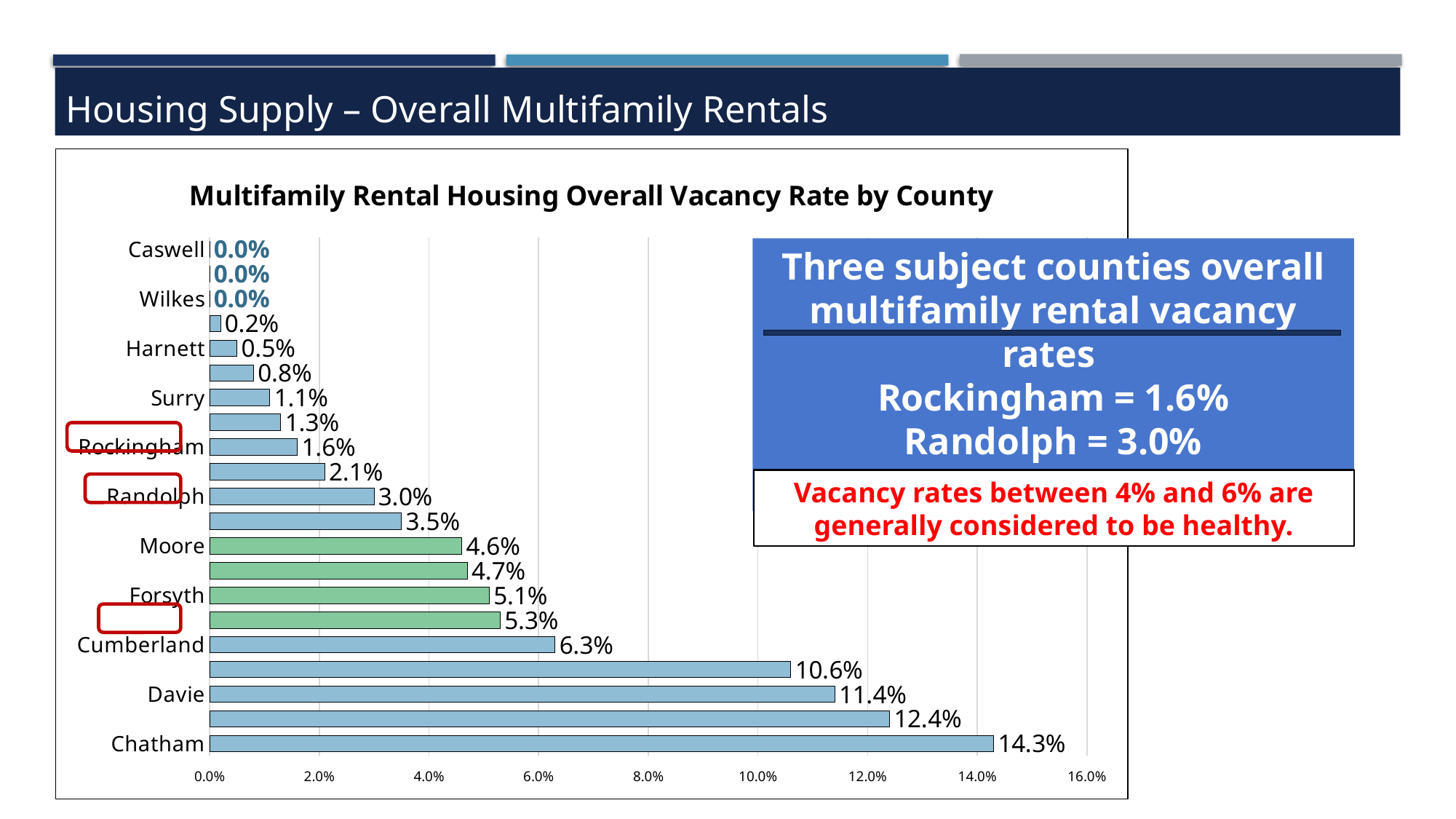
What is the vacancy rate for Cumberland? 6.3% What is the difference between the vacancy rates of Chatham and Davie? 2.9% What is the vacancy rate for Rockingham? 1.6% What is the title of the chart? Multifamily Rental Housing Overall Vacancy Rate by County What type of chart is shown on the slide? bar chart Which has a higher vacancy rate, Moore or Forsyth? Forsyth Which county has the highest vacancy rate? Chatham What is the vacancy rate for Davie? 11.4% What is the difference between the vacancy rates of Randolph and Rockingham? 1.4% How many bars are plotted in the chart? 21 What is the vacancy rate for Chatham? 14.3% What is the vacancy rate for Randolph? 3.0%